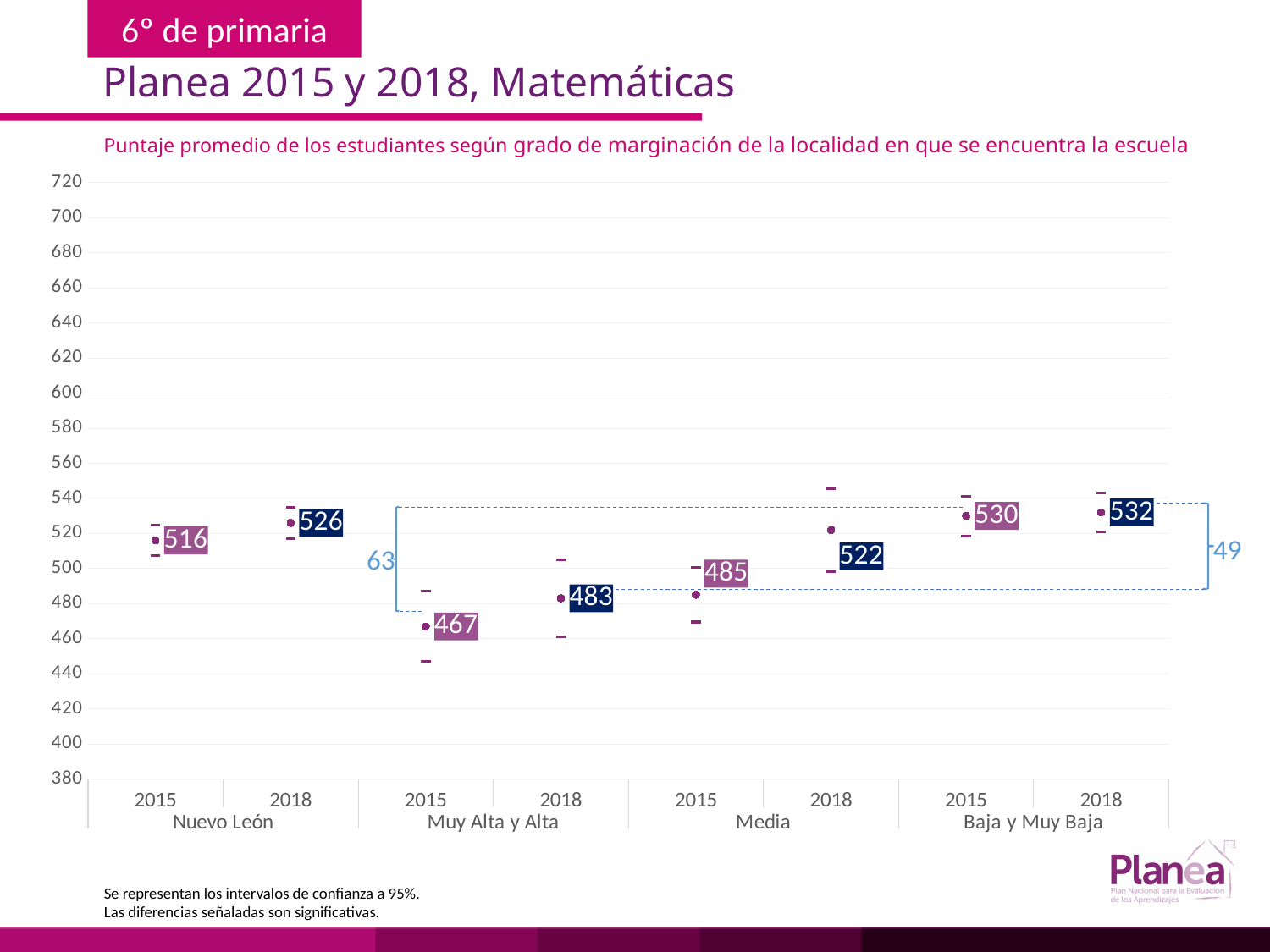
What is the average score for Muy Alta y Alta in 2018? 483 What is the average score for Baja y Muy Baja in 2018? 532 Which category and year has the highest average score? Baja y Muy Baja, 2018 What is the difference between the 2018 and 2015 scores for Media? 37 Is the 2015 score for Muy Alta y Alta greater or less than 480? less Which category and year has the lowest average score? Muy Alta y Alta, 2015 How many data points are plotted on the chart? 8 What is the difference between the 2018 and 2015 scores for Nuevo León? 10 What is the average score for Media in 2015? 485 What is the subtitle of the chart? Puntaje promedio de los estudiantes según grado de marginación de la localidad en que se encuentra la escuela What is the average score for Nuevo León in 2015? 516 Which is larger, the 2018 score for Muy Alta y Alta or the 2015 score for Media? 2015 score for Media